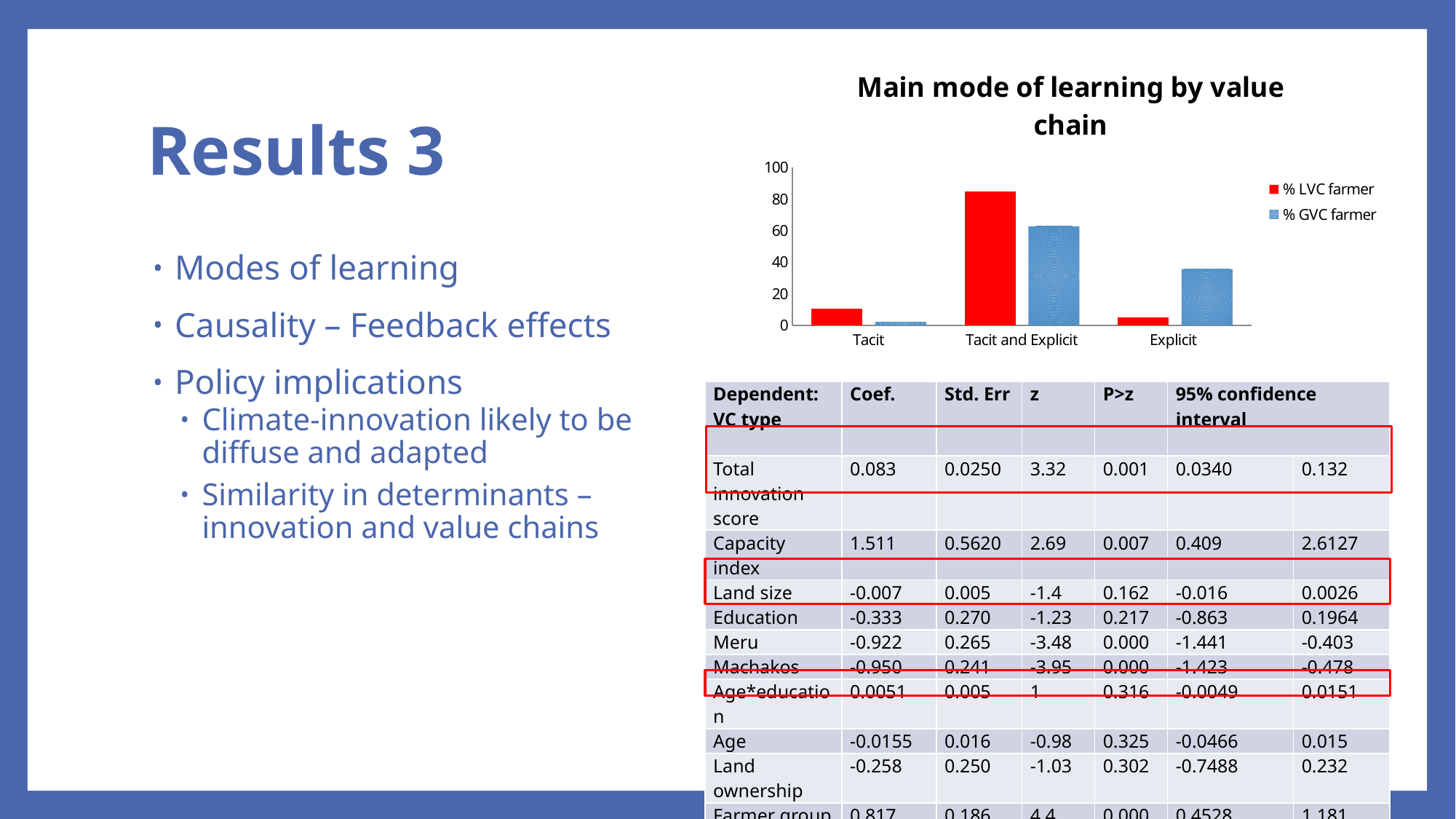
Is the value for % LVC farmer in the Tacit and Explicit category greater or less than 80? greater How many categories are shown on the x axis of the chart? 3 How many series does the chart's legend list? 2 For the Tacit and Explicit category, which series has the larger value, % LVC farmer or % GVC farmer? % LVC farmer Which category has the highest value for % LVC farmer? Tacit and Explicit Which colour represents the % LVC farmer series in the chart? red Is the value for % GVC farmer in the Explicit category greater or less than 40? less For the Explicit category, which series has the larger value, % LVC farmer or % GVC farmer? % GVC farmer What is the title of the chart? Main mode of learning by value chain Which category has the lowest value for % GVC farmer? Tacit Which category has the lowest value for % LVC farmer? Explicit What kind of chart is shown on the slide? bar chart